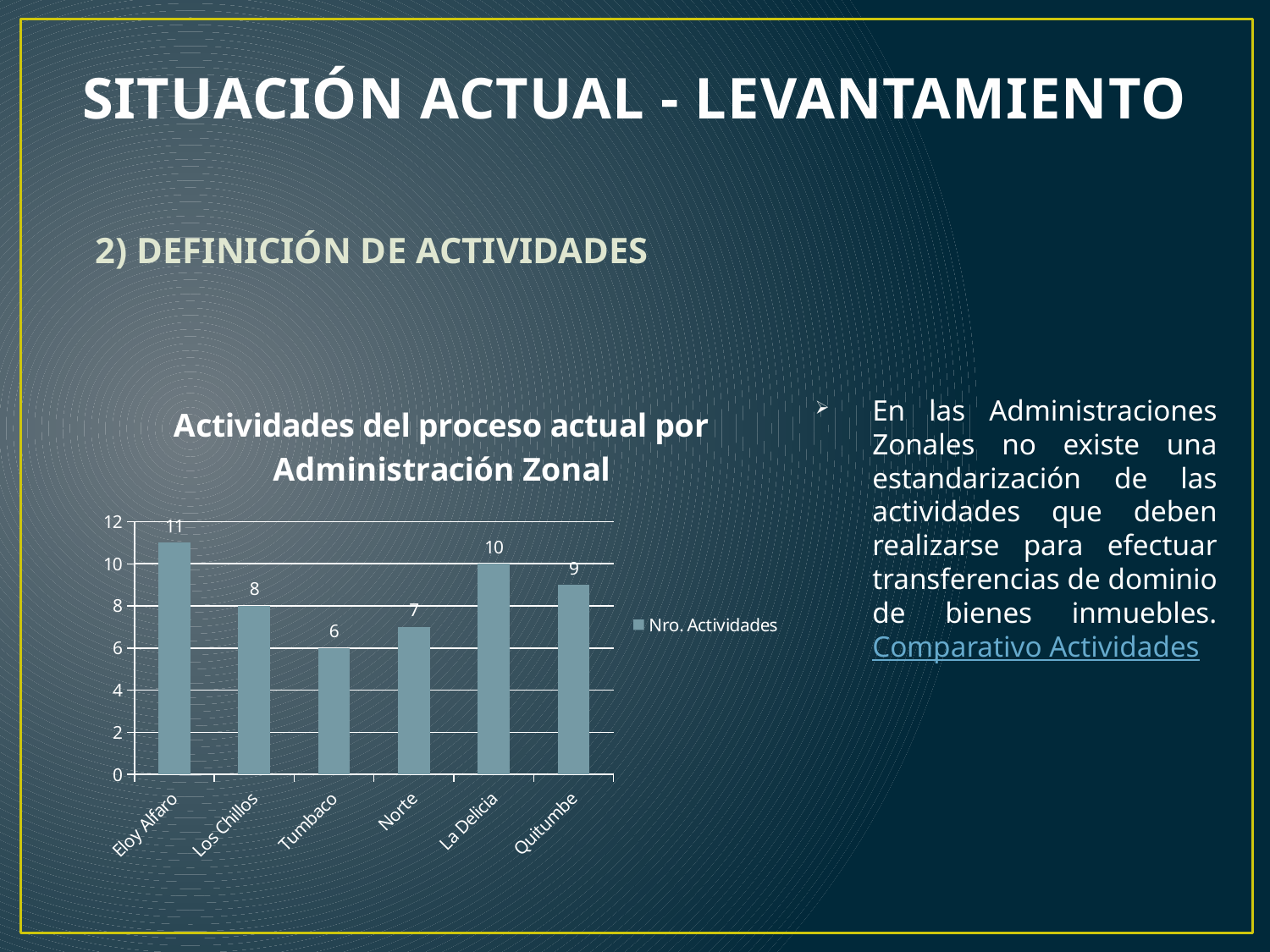
What is the title of the chart? Actividades del proceso actual por Administración Zonal What is the value for Eloy Alfaro? 11 What kind of chart is shown on the slide? bar chart What is the difference between the values for Eloy Alfaro and Tumbaco? 5 What is the value for Tumbaco? 6 What is the value for La Delicia? 10 Is the value for Quitumbe greater or less than 8? greater How many Administraciones Zonales are shown on the x axis? 6 How many series does the legend list? 1 Which Administración Zonal has the highest number of activities? Eloy Alfaro Which is larger, the value for Los Chillos or the value for Norte? Los Chillos Which Administración Zonal has the lowest number of activities? Tumbaco